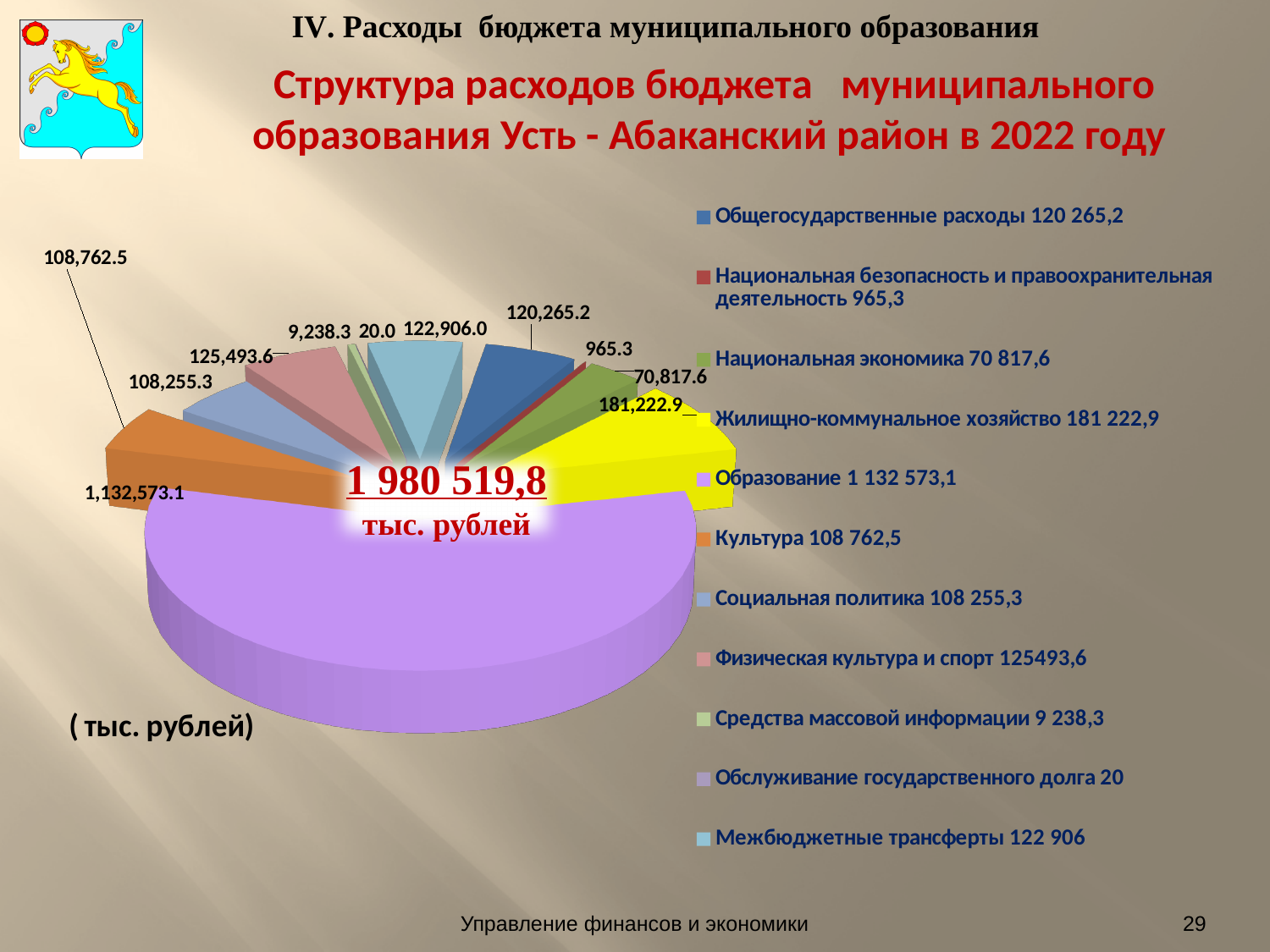
What unit is stated below the pie chart? тыс. рублей What is the difference between Общегосударственные расходы (120,265.2) and Культура (108,762.5)? 11,502.7 Which category has the smallest value in the pie chart? Обслуживание государственного долга How many categories does the pie chart show? 11 What total value is printed in the centre of the pie chart? 1 980 519,8 тыс. рублей Which category has the largest slice in the pie chart? Образование What is the value for Межбюджетные трансферты in the pie chart? 122,906.0 What is the value for Обслуживание государственного долга in the pie chart? 20.0 What type of chart is shown on the slide? pie chart Which is larger: Культура or Социальная политика? Культура What is the value for Образование in the pie chart? 1,132,573.1 What is the value for Жилищно-коммунальное хозяйство in the pie chart? 181,222.9